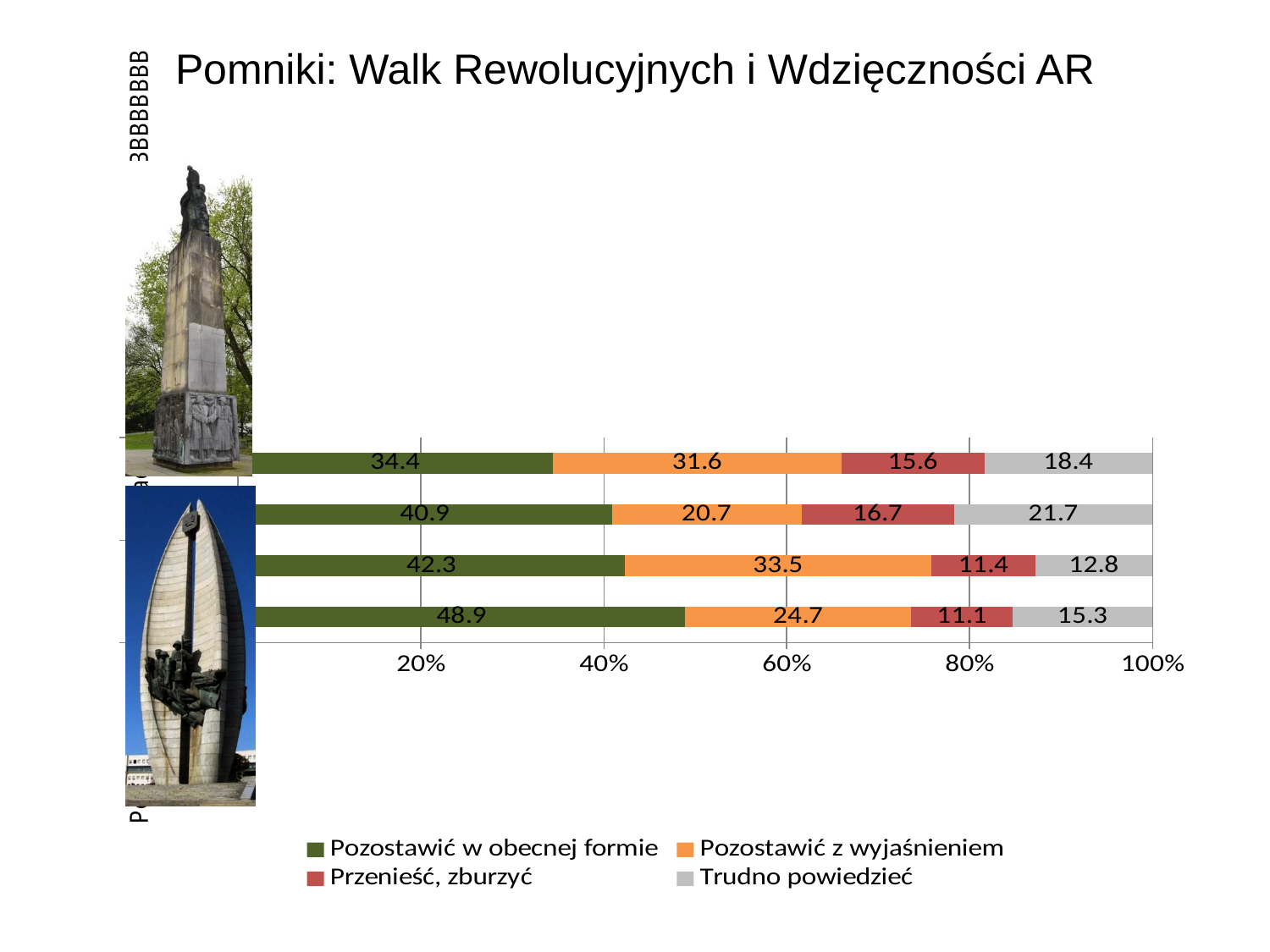
How many bars are plotted in the chart? 4 How many series does the legend list? 4 What type of chart is shown on the slide? stacked bar chart What is the value of 'Trudno powiedzieć' in the bottom bar? 15.3 What is the value of 'Przenieść, zburzyć' in the second bar from the top? 16.7 Which bar has the lowest value for 'Przenieść, zburzyć'? the bottom bar Which bar has the highest value for 'Pozostawić w obecnej formie'? the bottom bar What is the difference between the 'Pozostawić w obecnej formie' values of the bottom bar and the top bar? 14.5 What is the value of 'Pozostawić z wyjaśnieniem' in the third bar from the top? 33.5 Which legend entry is shown in grey? Trudno powiedzieć In the top bar, which is larger: 'Pozostawić z wyjaśnieniem' or 'Trudno powiedzieć'? Pozostawić z wyjaśnieniem What is the value of 'Pozostawić w obecnej formie' in the top bar? 34.4